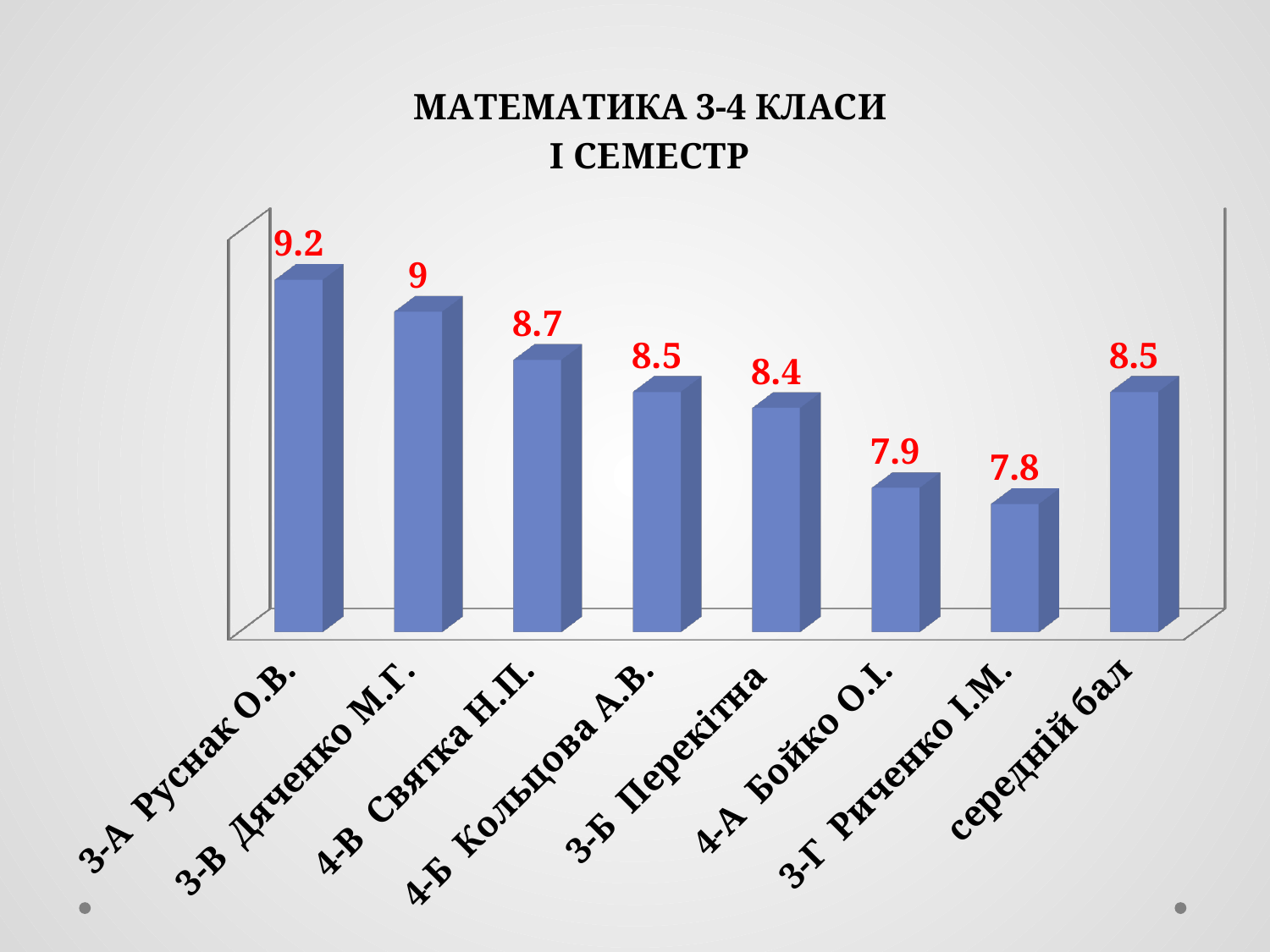
What is the value for 3-А Руснак О.В.? 9.2 What kind of chart is shown on the slide? bar chart What is the value for 3-Б Перекітна? 8.4 What is the difference between the values for 3-В Дяченко М.Г. and 4-А Бойко О.І.? 1.1 How many bars are shown in the chart? 8 What is the title of the chart? МАТЕМАТИКА 3-4 КЛАСИ І СЕМЕСТР What is the difference between the values for 3-А Руснак О.В. and 3-Г Риченко І.М.? 1.4 Which category has the highest value? 3-А Руснак О.В. What is the value for 4-В Святка Н.П.? 8.7 What is the value shown for середній бал? 8.5 Which category has the lowest value? 3-Г Риченко І.М. Which is larger, the value for 4-Б Кольцова А.В. or the value for 4-А Бойко О.І.? 4-Б Кольцова А.В.